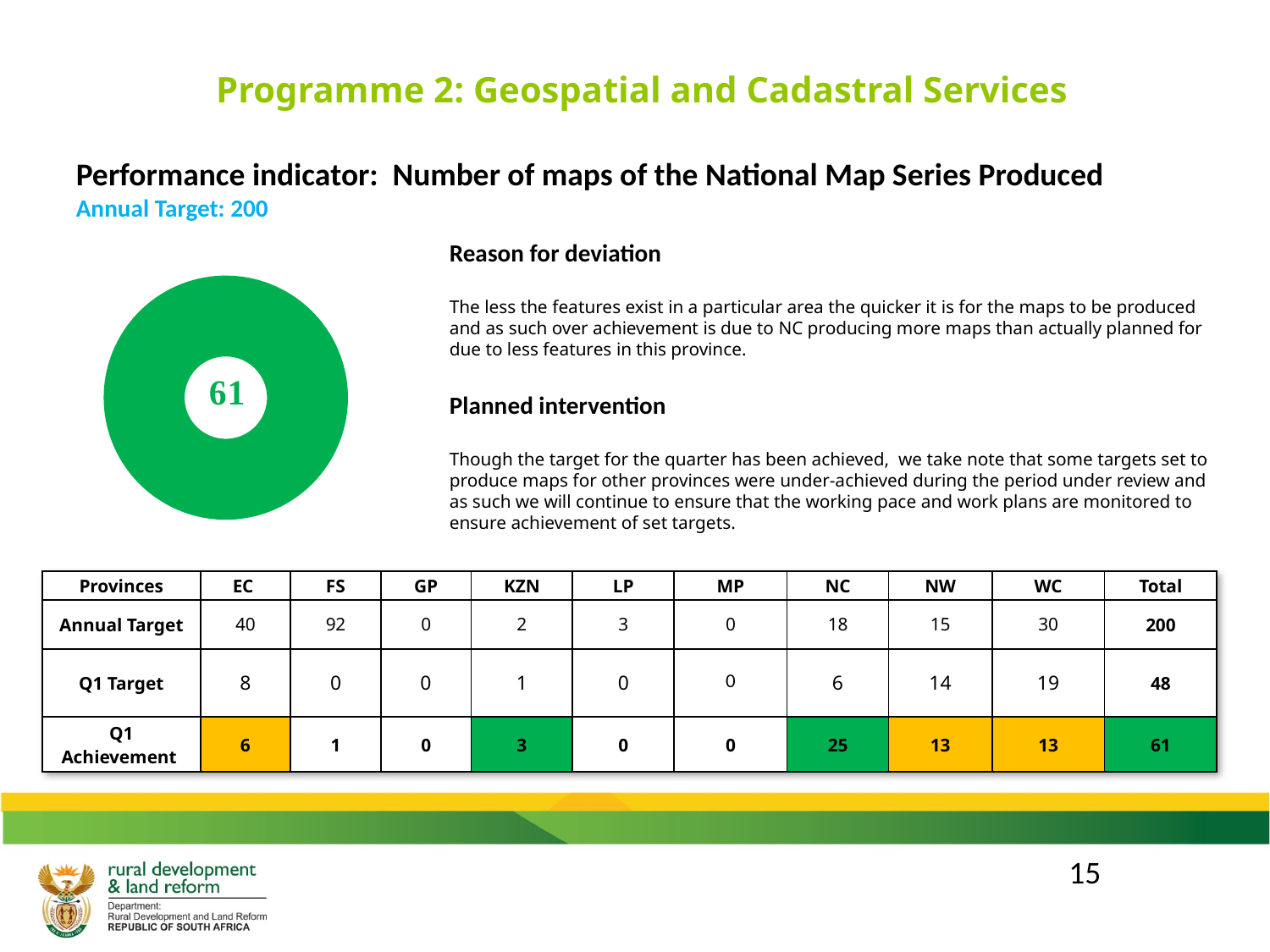
What colour is the ring of the doughnut chart? green What kind of chart is shown on the left of the slide? doughnut chart Does the doughnut chart display a legend? No How many slices does the doughnut chart show? 1 What value is displayed in the centre of the doughnut chart? 61